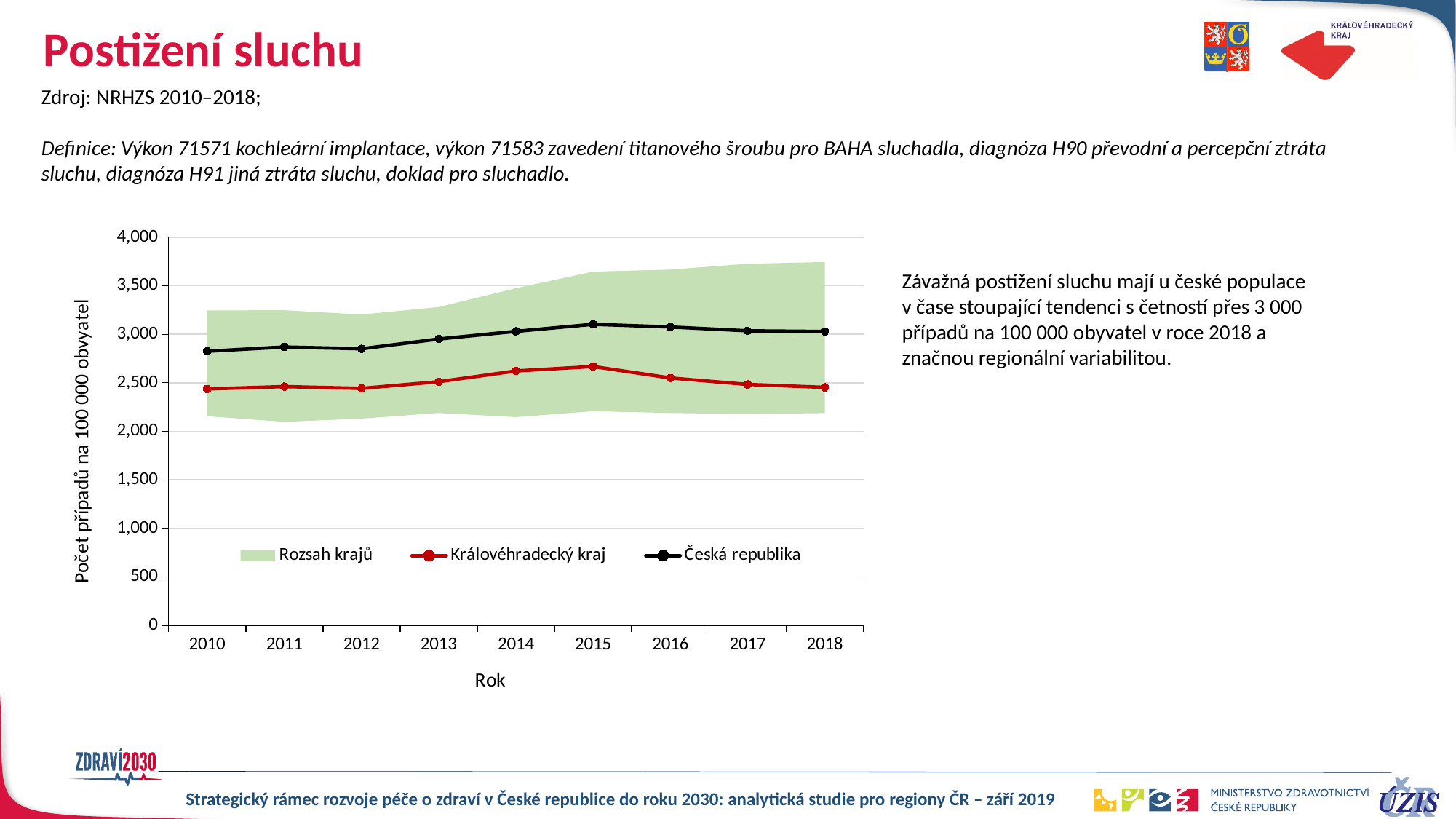
What is the label of the chart's vertical axis? Počet případů na 100 000 obyvatel How many years are plotted along the x axis of the chart? 9 Is the value for Česká republika in 2010 greater or less than 3,000? less Is the value for Česká republika in 2015 greater or less than 3,000? greater In which year does the Královéhradecký kraj series reach its highest value? 2015 Which legend entry is shown as a green shaded area? Rozsah krajů In 2018, which series has the higher value: Královéhradecký kraj or Česká republika? Česká republika Does the Královéhradecký kraj series rise or fall between 2012 and 2015? rise How many entries does the chart's legend list? 3 Is the value for Královéhradecký kraj in 2010 greater or less than 2,500? less What kind of chart is shown on the slide? combination area and line chart (two lines with a shaded area band)